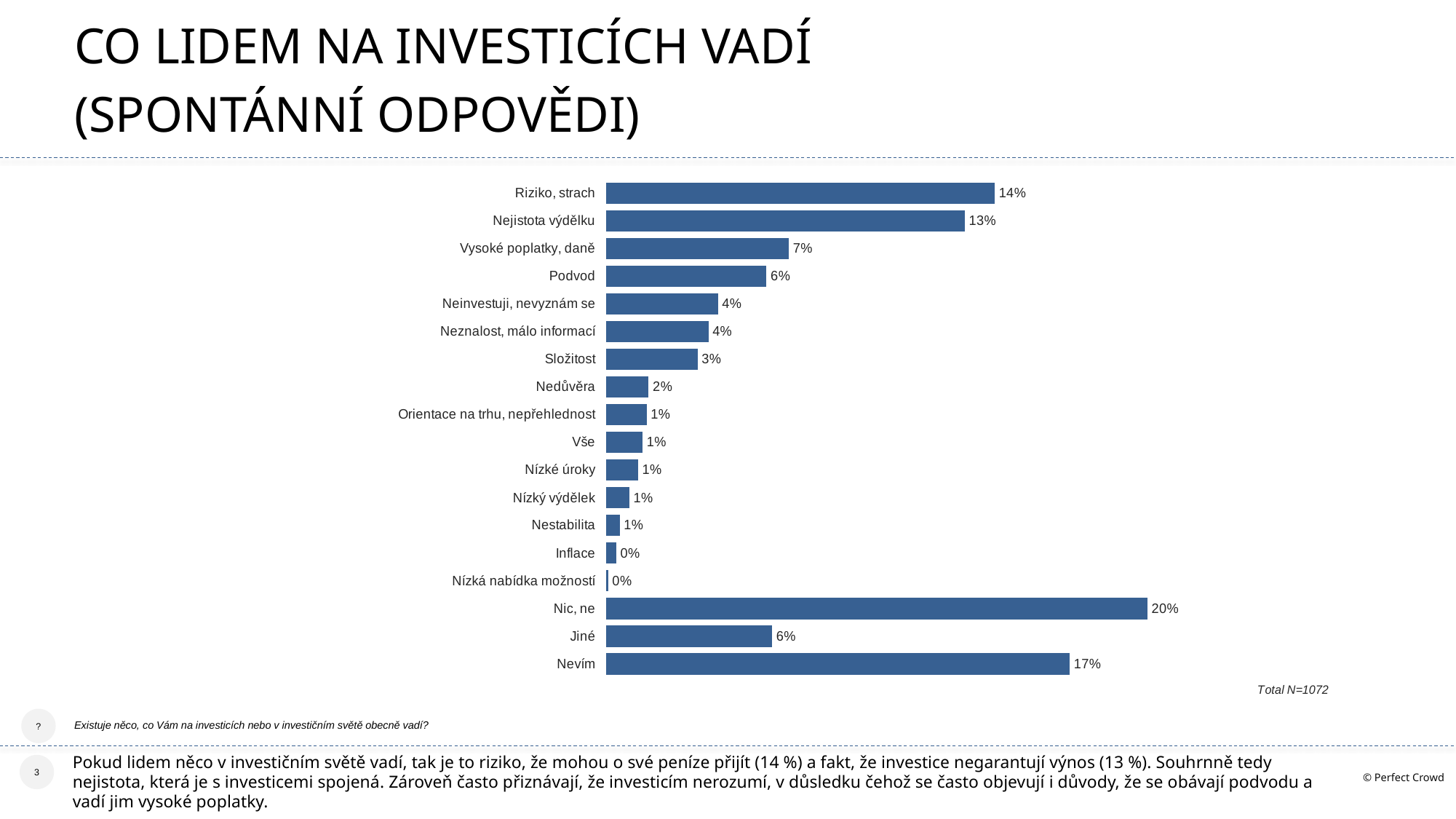
Which category has the highest value? Nic, ne What is the difference between the values for "Riziko, strach" and "Vysoké poplatky, daně"? 7% Which is larger, the value for "Jiné" or the value for "Nevím"? Nevím What is the value for "Nevím"? 17% What is the value for "Nejistota výdělku"? 13% What is the total N stated below the chart? Total N=1072 What is the value for "Riziko, strach"? 14% What is the difference between the values for "Nic, ne" and "Nevím"? 3% How many categories are shown in the chart? 18 What kind of chart is shown on the slide? Bar chart Which is larger, the value for "Složitost" or the value for "Nedůvěra"? Složitost What is the value for "Podvod"? 6%